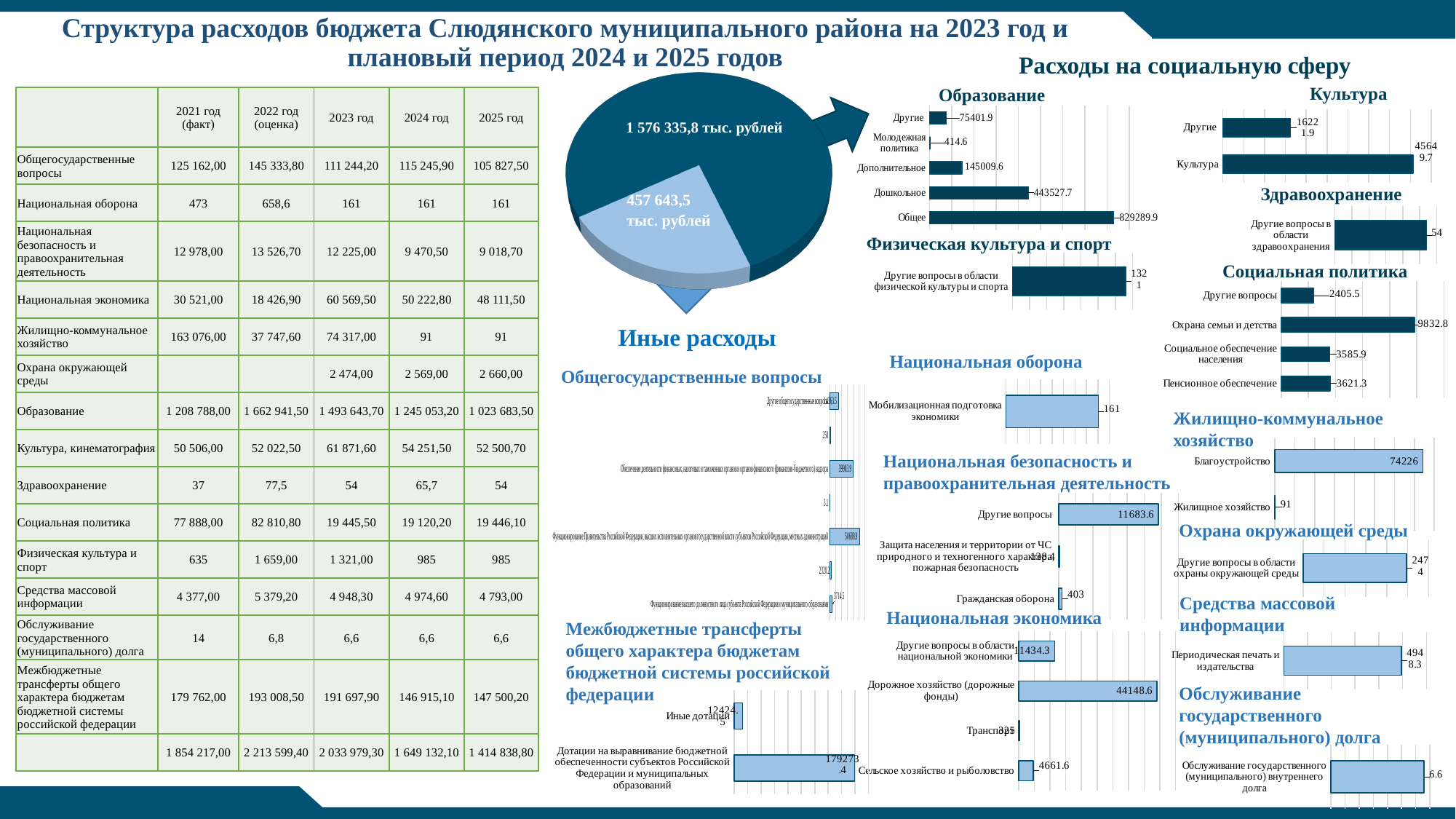
How many categories does the Образование chart show? 5 In the Социальная политика chart, what is the value for Пенсионное обеспечение? 3621.3 What kind of chart is used for Национальная оборона? bar chart In the Образование chart, which category has the lowest value? Молодежная политика In the Национальная экономика chart, what is the value for Дорожное хозяйство (дорожные фонды)? 44148.6 In the Образование chart, what is the value for Общее? 829289.9 In the Национальная экономика chart, which is larger: Другие вопросы в области национальной экономики or Сельское хозяйство и рыболовство? Другие вопросы в области национальной экономики In the Социальная политика chart, which category has the highest value? Охрана семьи и детства In the Жилищно-коммунальное хозяйство chart, what is the value for Благоустройство? 74226 In the Образование chart, what is the difference between Дошкольное and Дополнительное? 298518.1 In the Национальная безопасность и правоохранительная деятельность chart, what is the value for Гражданская оборона? 403 In the pie chart at the top of the slide, what is the value of the smaller slice? 457 643,5 тыс. рублей